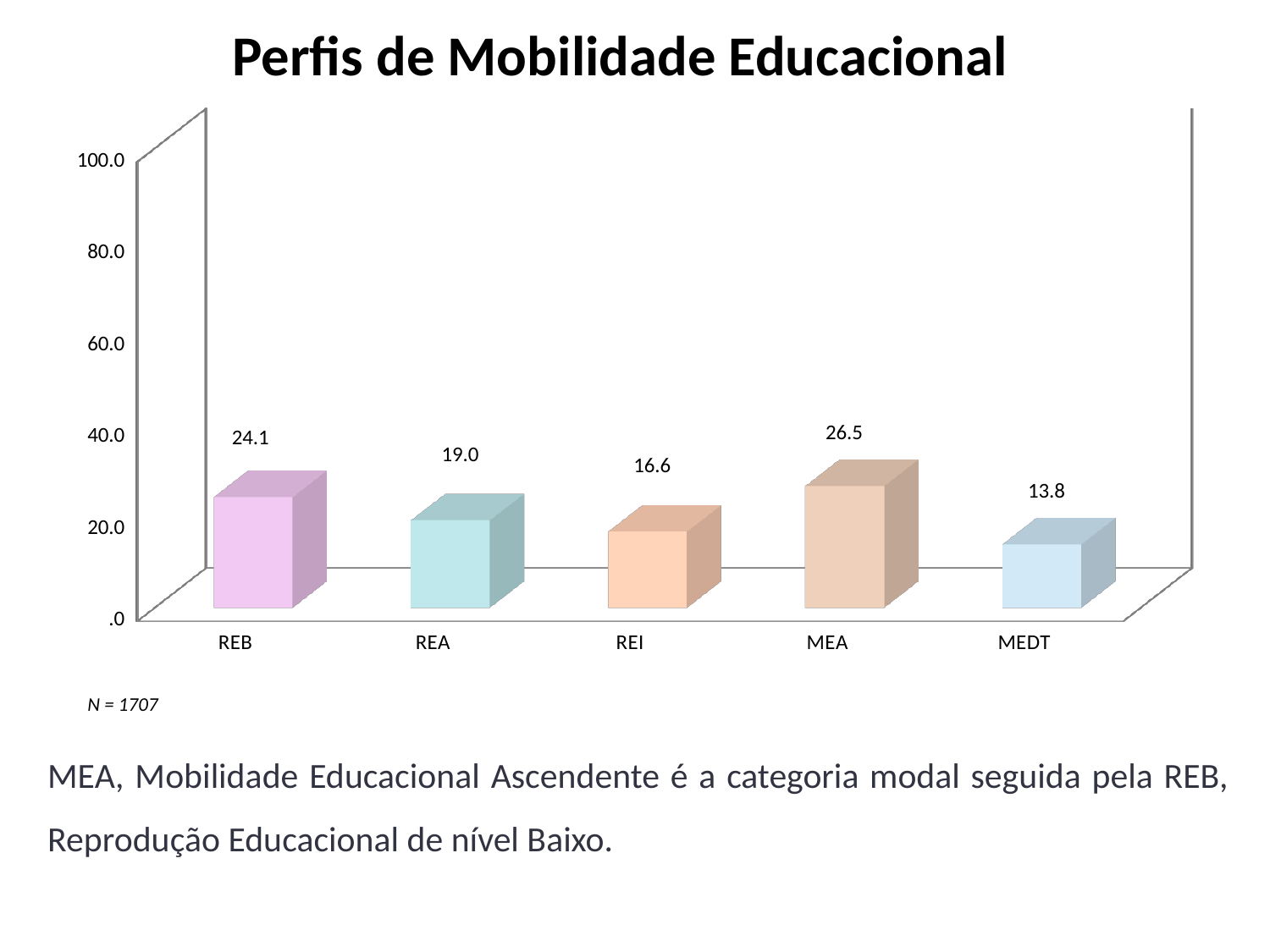
What is the title of the chart? Perfis de Mobilidade Educacional What is the difference between the values for MEA and REB? 2.4 How many categories are shown on the x axis? 5 Which is larger, the value for REA or the value for REI? REA What kind of chart is shown on the slide? bar chart What is the value for REB? 24.1 What is the value for REI? 16.6 Which category has the lowest value? MEDT Which category has the highest value? MEA What is the value for MEDT? 13.8 What is the difference between the values for REA and MEDT? 5.2 Is the value for MEA greater or less than 20.0? greater